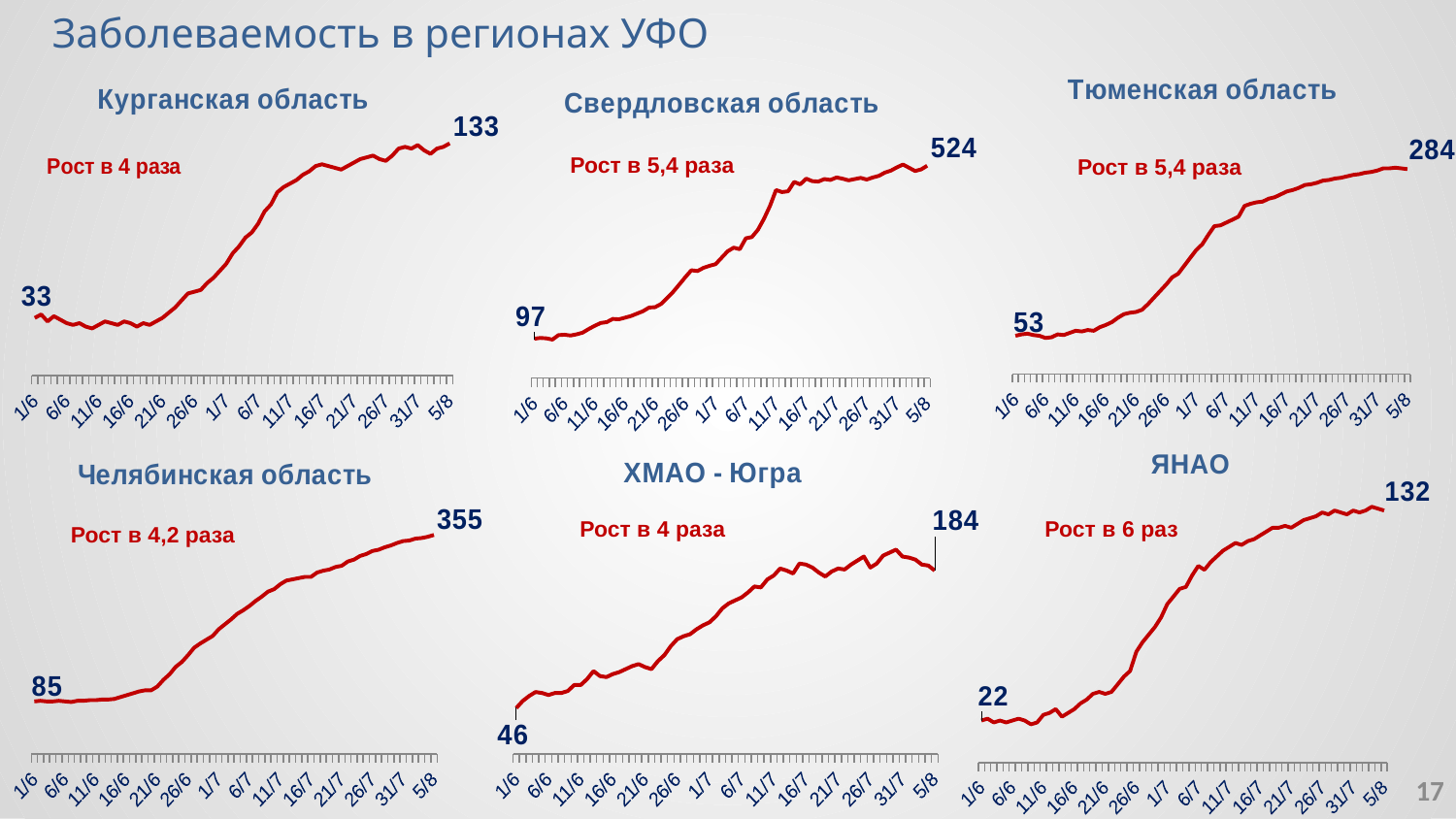
On the Свердловская область chart, do the values rise or fall from 1/6 to 5/8? rise On the ЯНАО chart, what is the starting value shown? 22 Which of the six regional charts shows the highest final value? Свердловская область On the ХМАО - Югра chart, what is the difference between the final value (184) and the starting value (46)? 138 On the Курганская область chart, what is the value at the end of the line (5/8)? 133 What kind of chart is used for each region on this slide? line chart On the Челябинская область chart, what is the difference between the final value and the starting value? 270 What growth factor is annotated on the ЯНАО chart? Рост в 6 раз On the Тюменская область chart, what is the final value shown? 284 On the Свердловская область chart, what is the value at the start of the line (1/6)? 97 Is the final value on the Челябинская область chart larger or smaller than the final value on the Тюменская область chart? larger Which of the six regional charts shows the lowest starting value? ЯНАО